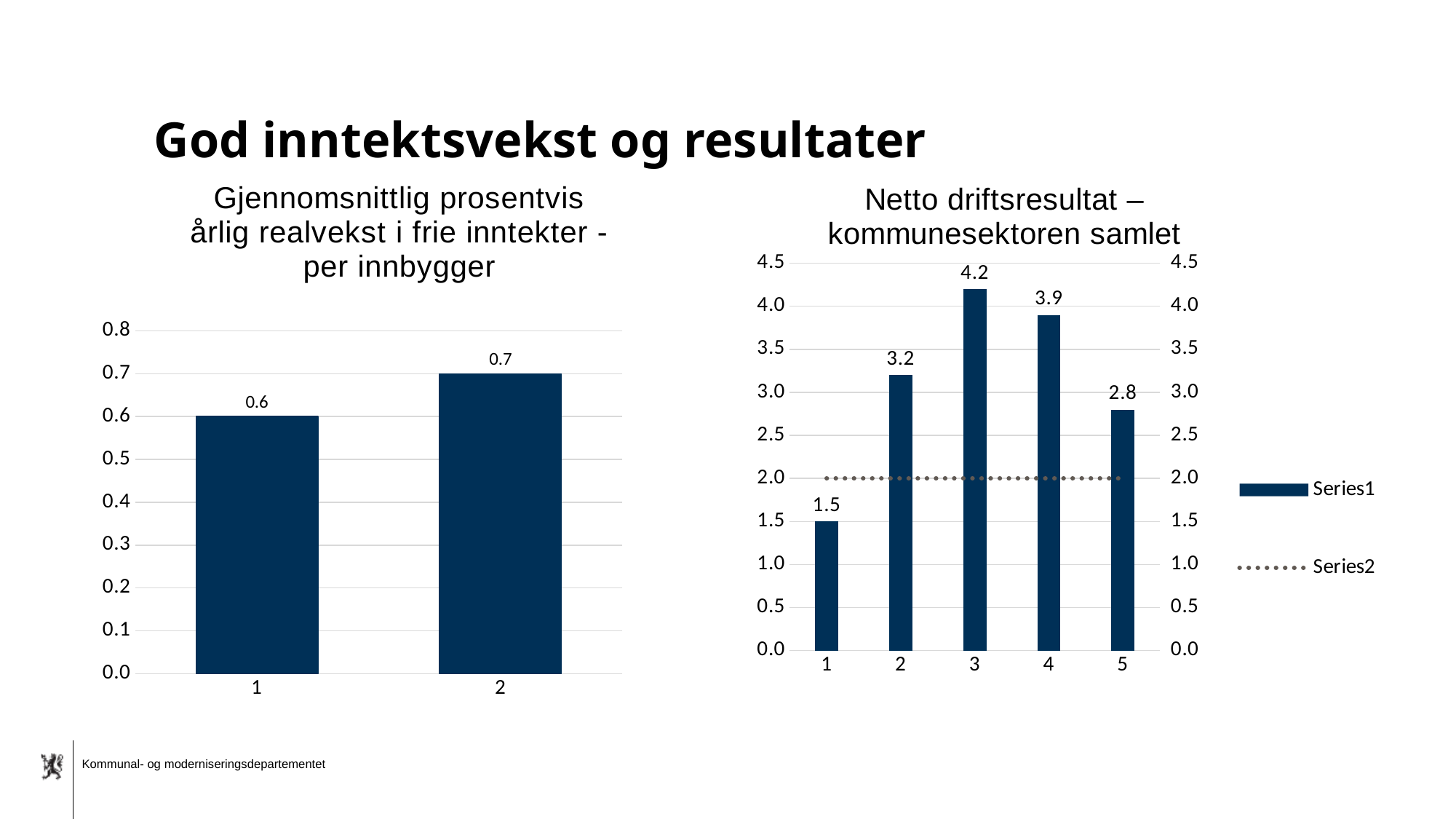
In the chart 'Gjennomsnittlig prosentvis årlig realvekst i frie inntekter - per innbygger', how many bars are plotted? 2 What kind of chart is 'Gjennomsnittlig prosentvis årlig realvekst i frie inntekter - per innbygger'? Bar chart In the chart 'Netto driftsresultat – kommunesektoren samlet', which is larger: the Series1 value for category 2 or for category 4? Category 4 In the chart 'Netto driftsresultat – kommunesektoren samlet', how many series does the legend list? 2 In the chart 'Netto driftsresultat – kommunesektoren samlet', what is the Series1 value for category 3? 4.2 In the chart 'Gjennomsnittlig prosentvis årlig realvekst i frie inntekter - per innbygger', what is the value for category 2? 0.7 In the chart 'Netto driftsresultat – kommunesektoren samlet', what is the difference between the Series1 values for category 3 and category 5? 1.4 In the chart 'Netto driftsresultat – kommunesektoren samlet', which category has the highest Series1 value? 3 In the chart 'Netto driftsresultat – kommunesektoren samlet', which category has the lowest Series1 value? 1 In the chart 'Netto driftsresultat – kommunesektoren samlet', what is the Series1 value for category 1? 1.5 In the chart 'Gjennomsnittlig prosentvis årlig realvekst i frie inntekter - per innbygger', what is the difference between the values for category 2 and category 1? 0.1 In the chart 'Gjennomsnittlig prosentvis årlig realvekst i frie inntekter - per innbygger', what is the value for category 1? 0.6